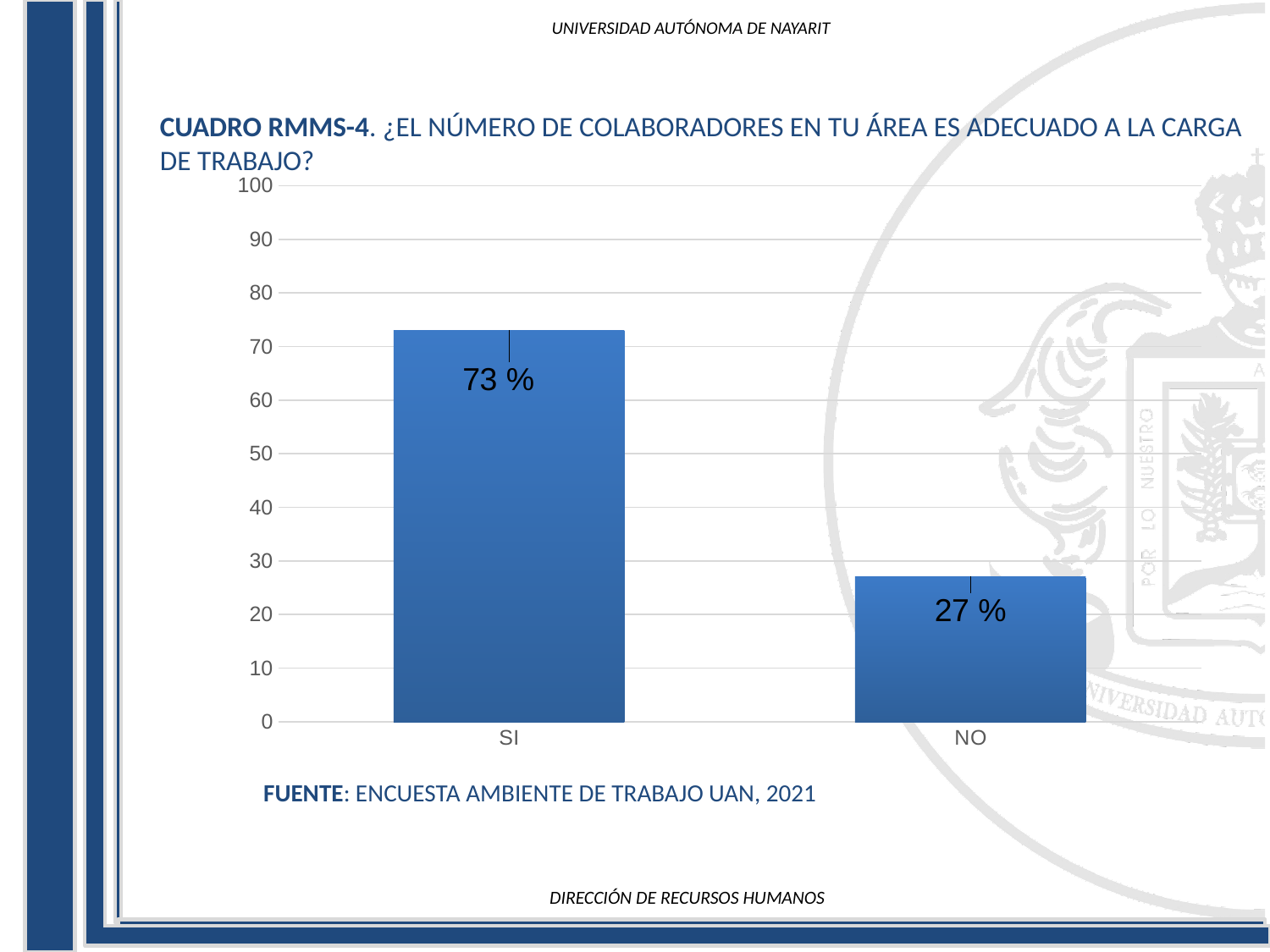
Which category has the highest value? SI How many categories are shown on the x axis? 2 What source is cited below the chart? ENCUESTA AMBIENTE DE TRABAJO UAN, 2021 What is the difference between the values for SI and NO? 46 % Which category has the lowest value? NO Is the value for NO greater or less than 30? less What is the value for NO? 27 % Is the value for SI greater or less than 70? greater What kind of chart is shown on the slide? bar chart Which is larger, the value for SI or the value for NO? SI What is the maximum value shown on the y axis? 100 What is the value for SI? 73 %